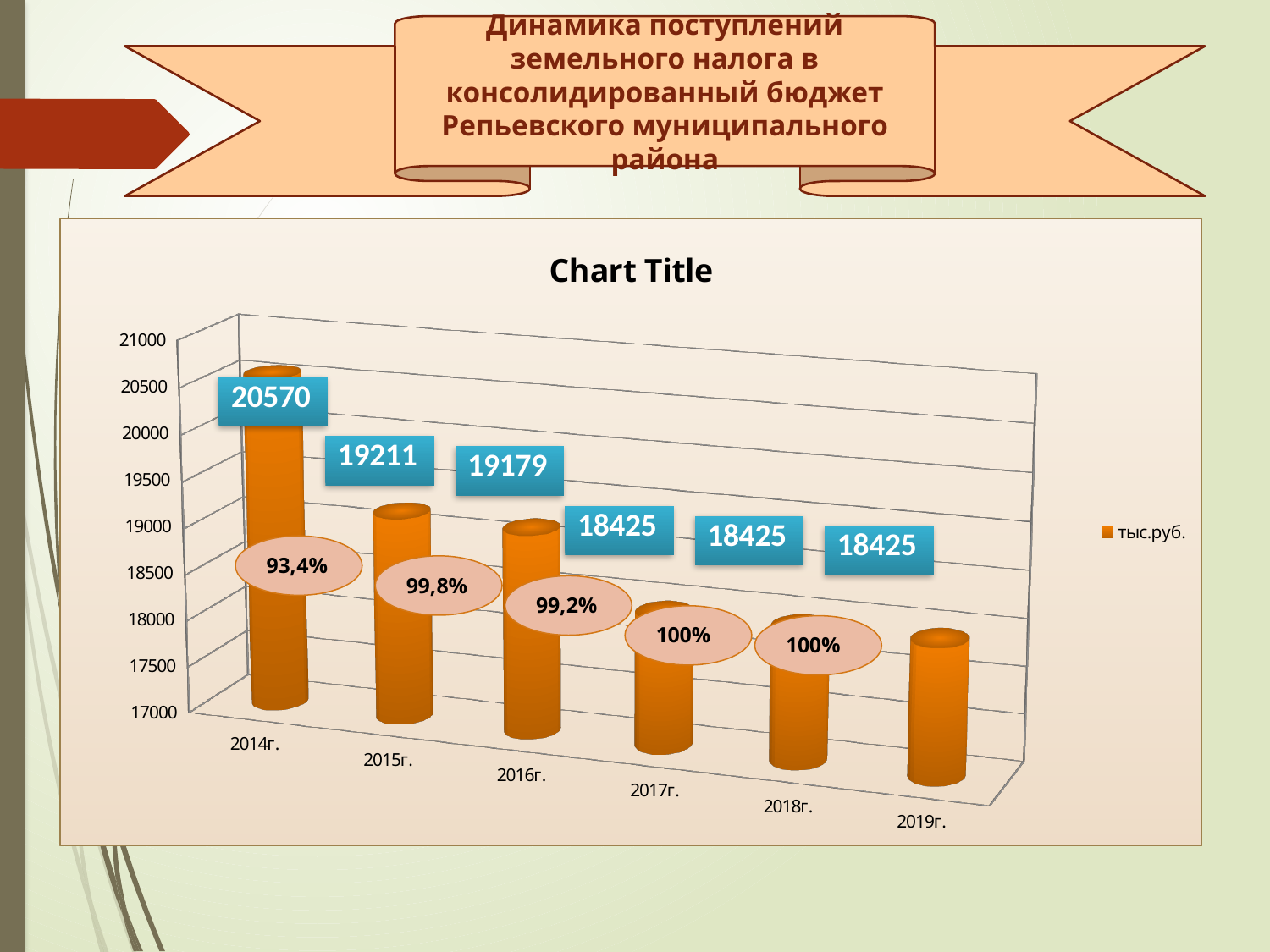
What is the value for 2018г.? 18425 What is the legend entry of the chart? тыс.руб. How many years are shown on the x axis? 6 Which year has the highest value? 2014г. Which is larger, the value for 2015г. or the value for 2016г.? 2015г. Do the values rise or fall from 2014г. to 2017г.? fall What is the difference between the values for 2014г. and 2015г.? 1359 What kind of chart is shown? bar chart What is the value for 2016г.? 19179 How many series does the legend list? 1 What is the value for 2014г.? 20570 What is the difference between the values for 2016г. and 2017г.? 754